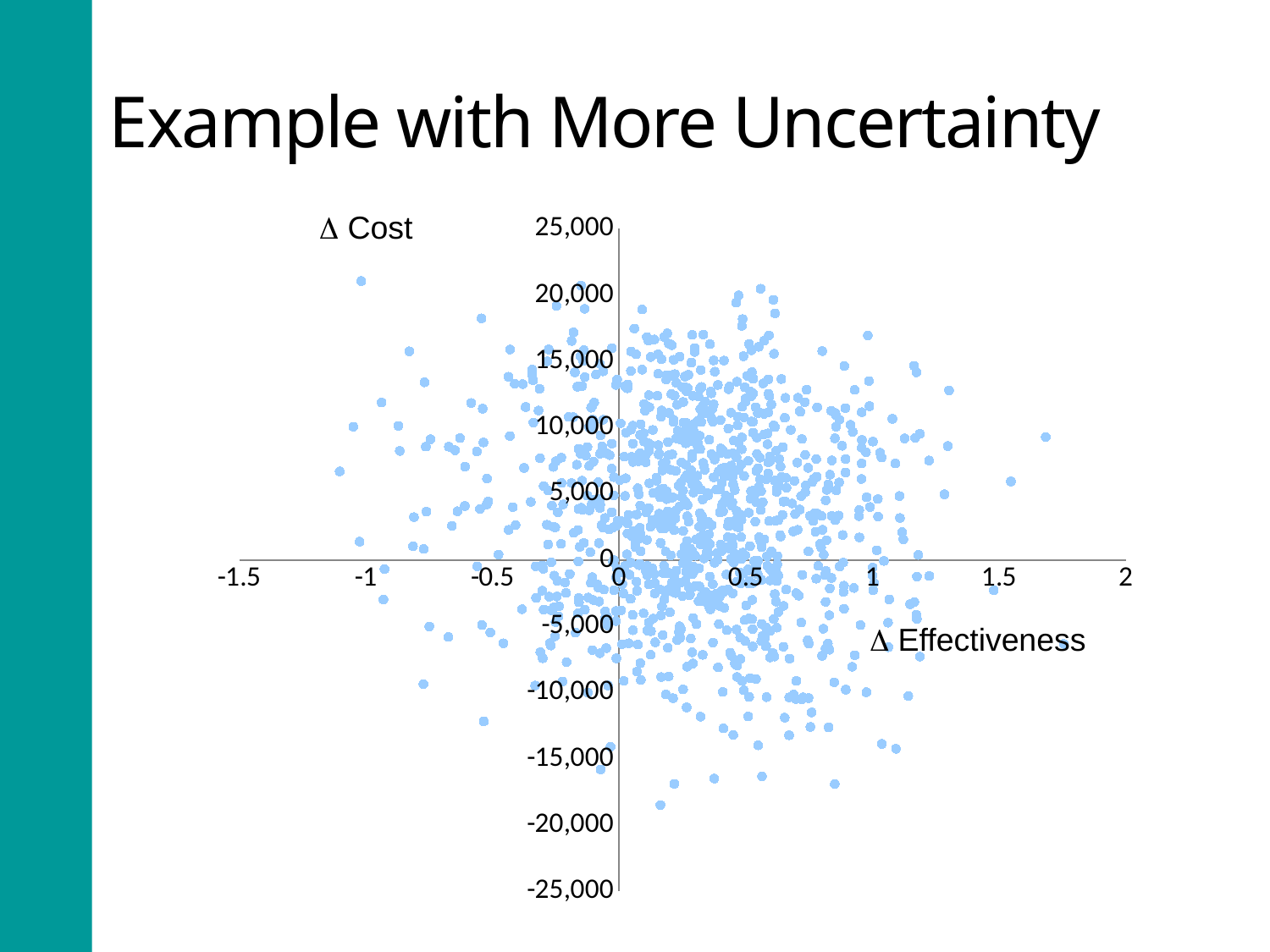
What is the label of the vertical axis of the chart? Δ Cost Are there more plotted points above the Δ Cost = 0 line or below it? above What kind of chart is shown on the slide? scatter plot What is the label of the horizontal axis of the chart? Δ Effectiveness Is the largest Δ Effectiveness value among the plotted points greater or less than 1.5? greater Is the largest Δ Cost value among the plotted points greater or less than 15,000? greater Is the smallest Δ Effectiveness value among the plotted points greater or less than -1? less Do most of the plotted points have a positive or a negative Δ Effectiveness value? positive